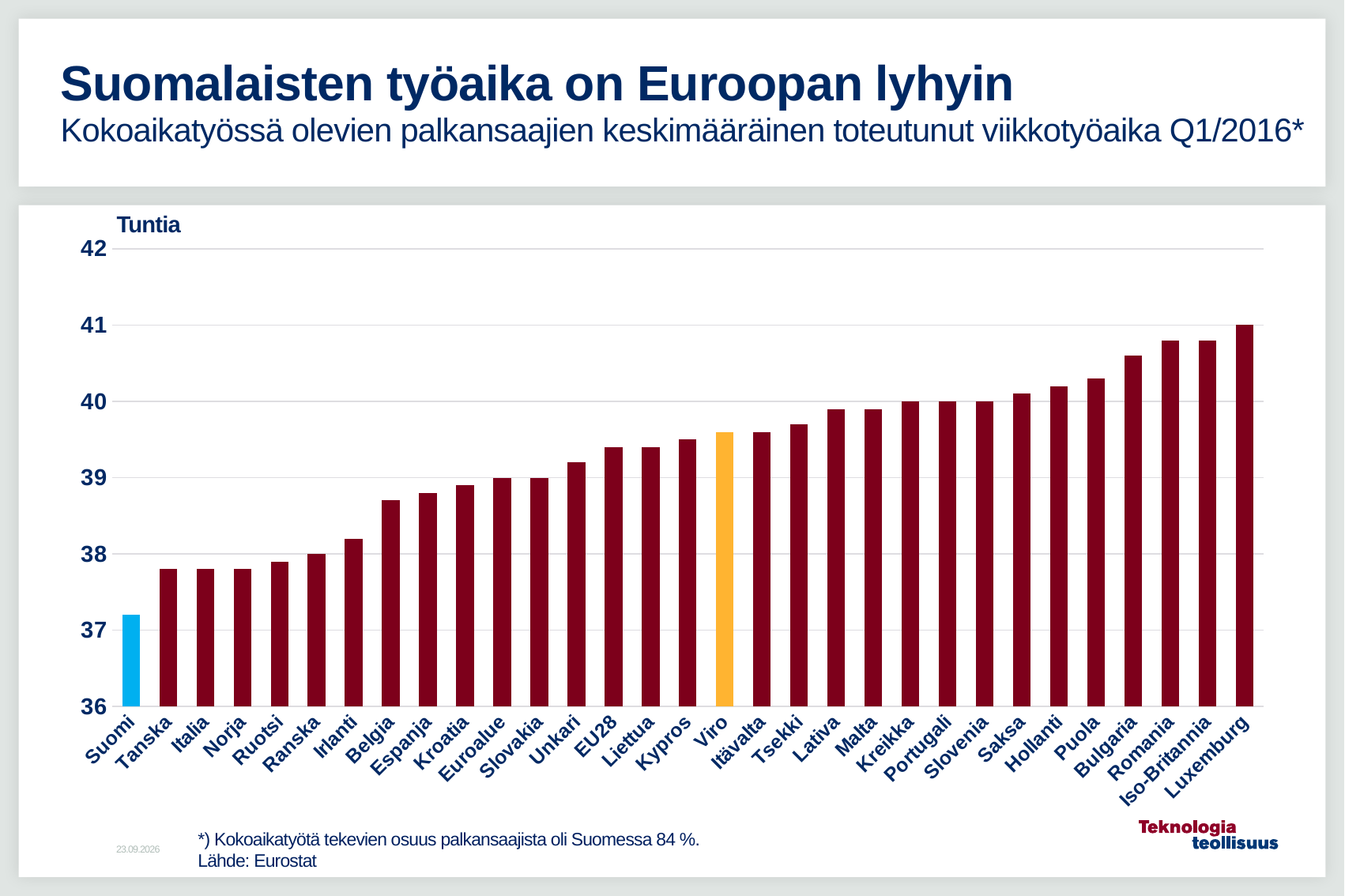
Is the value for Suomi greater or less than 38? less What is the value for Kreikka? 40 Is the value for Viro greater or less than 39? greater What is the value for Luxemburg? 41 Which country has the lowest weekly working time in the chart? Suomi What kind of chart is shown on the slide? bar chart What is the value for Euroalue? 39 Do the values rise or fall from left to right along the x axis? rise Which country has the highest weekly working time in the chart? Luxemburg How many categories (bars) are shown in the chart? 31 Is the value for Bulgaria greater or less than 40? greater What unit is shown as the label of the vertical axis? Tuntia